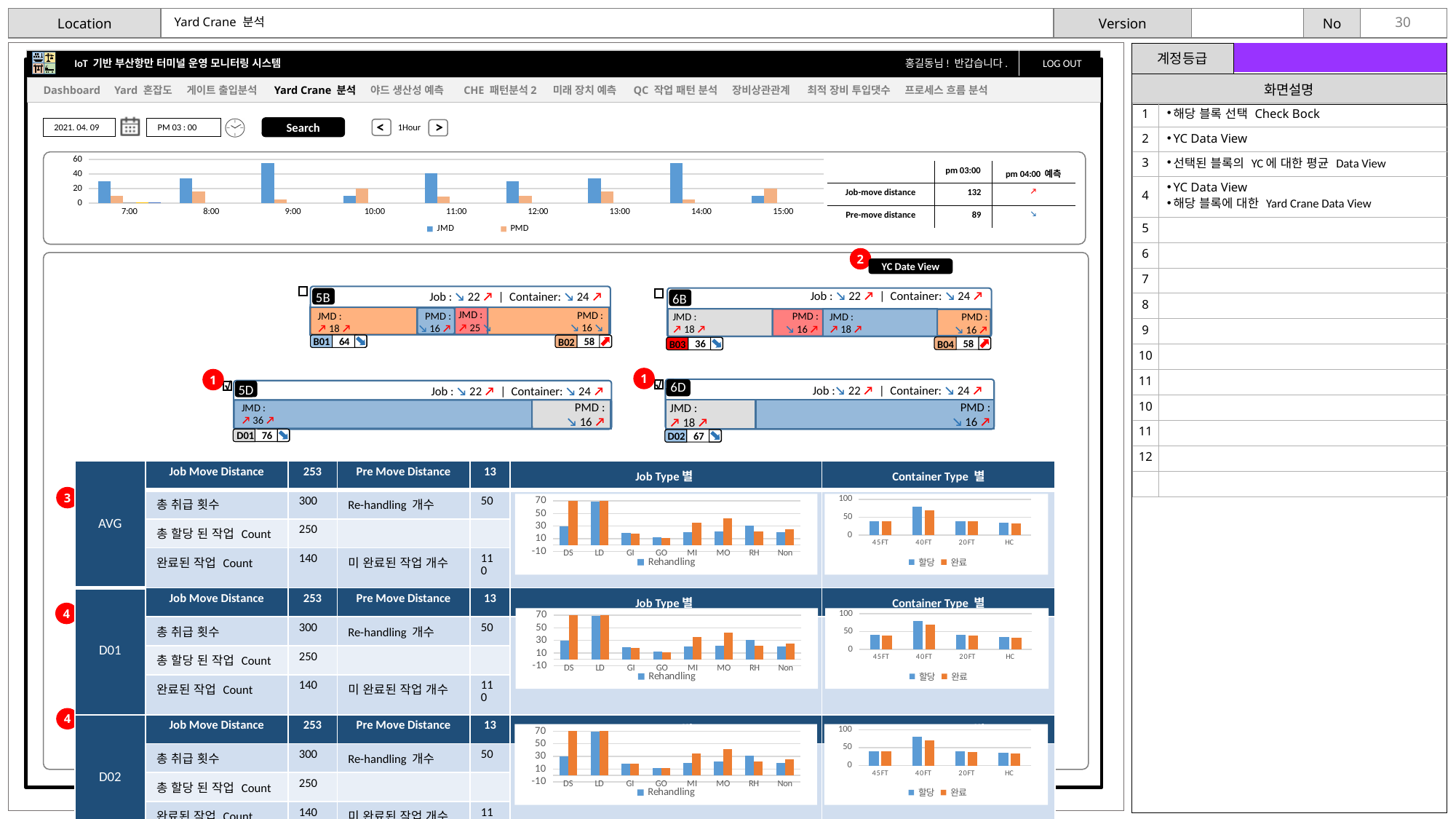
How many series does the legend of the top chart (JMD/PMD) list? 2 In the top chart (JMD/PMD), is the JMD value at 10:00 greater or less than 20? less How many series does the legend of the 'Container Type 별' chart in the AVG row list? 2 In the 'Job Type 별' chart in the AVG row, which category has the lowest values? GO How many categories are on the x axis of the 'Job Type 별' chart in the AVG row? 8 In the top chart (JMD/PMD), is the JMD value at 9:00 greater or less than 40? greater How many time categories are shown on the x axis of the top chart (JMD/PMD)? 9 In the 'Job Type 별' chart in the AVG row, are the values for LD greater or less than 50? greater In the 'Container Type 별' chart in the AVG row, which category has the highest value? 40FT What kind of chart is the chart at the top of the slide with the JMD and PMD legend? bar chart In the top chart (JMD/PMD), which is larger at 15:00, JMD or PMD? PMD In the top chart (JMD/PMD), which is larger at 7:00, JMD or PMD? JMD